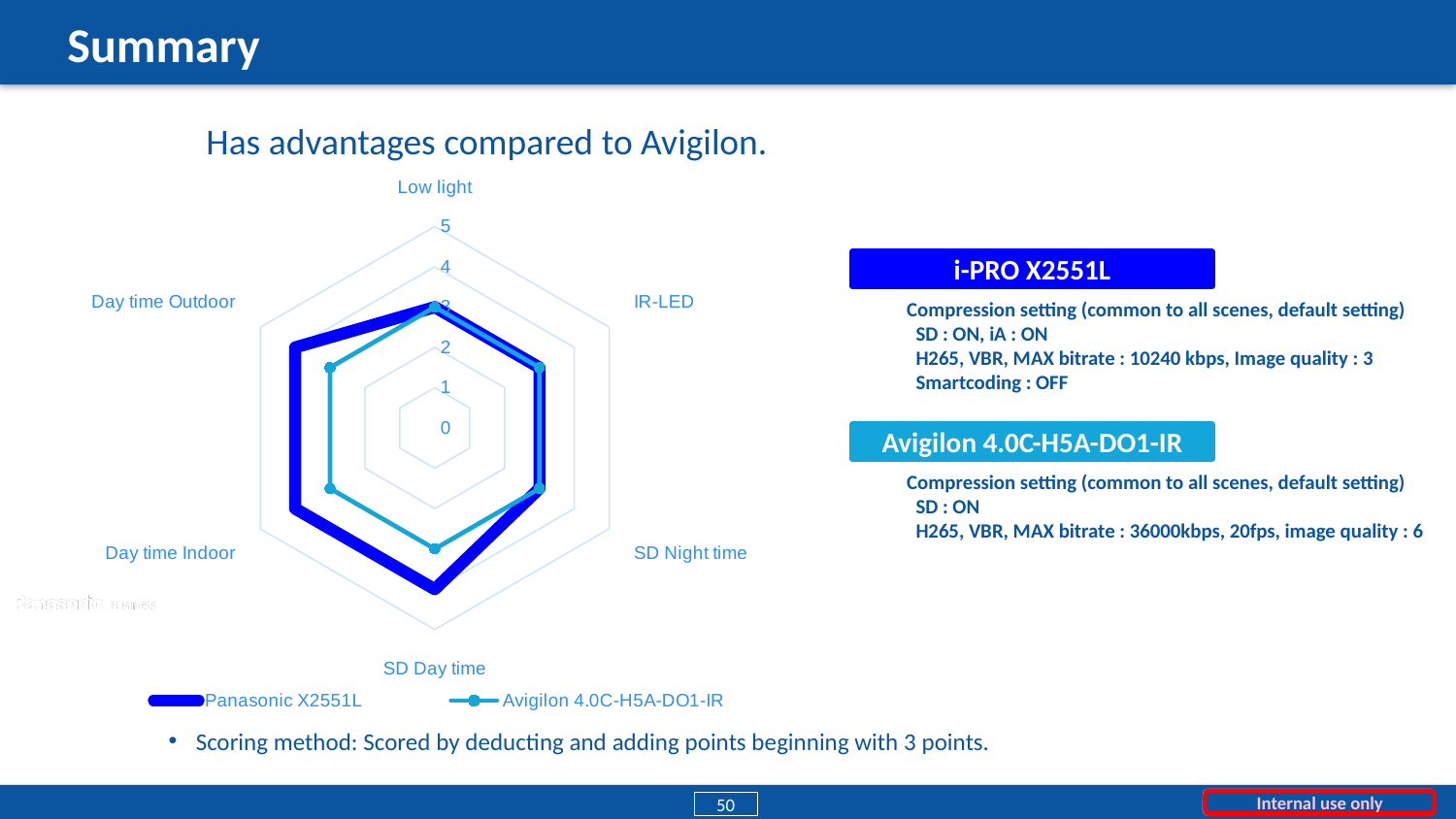
What score does Avigilon 4.0C-H5A-DO1-IR have for Low light? 3 For SD Day time, which series has the higher score, Panasonic X2551L or Avigilon 4.0C-H5A-DO1-IR? Panasonic X2551L Is the Panasonic X2551L score for SD Day time greater or less than 3? greater How many series does the legend of the radar chart list? 2 What kind of chart is shown on the slide? radar chart For Day time Outdoor, which series has the higher score, Panasonic X2551L or Avigilon 4.0C-H5A-DO1-IR? Panasonic X2551L Is the Avigilon 4.0C-H5A-DO1-IR score for Day time Indoor greater or less than 4? less Is the Panasonic X2551L score for Day time Indoor greater or less than 3? greater What is the maximum value shown on the radar chart's axis scale? 5 What are the two series names listed in the chart legend? Panasonic X2551L and Avigilon 4.0C-H5A-DO1-IR What score does Avigilon 4.0C-H5A-DO1-IR have for IR-LED? 3 How many categories (axes) does the radar chart have? 6